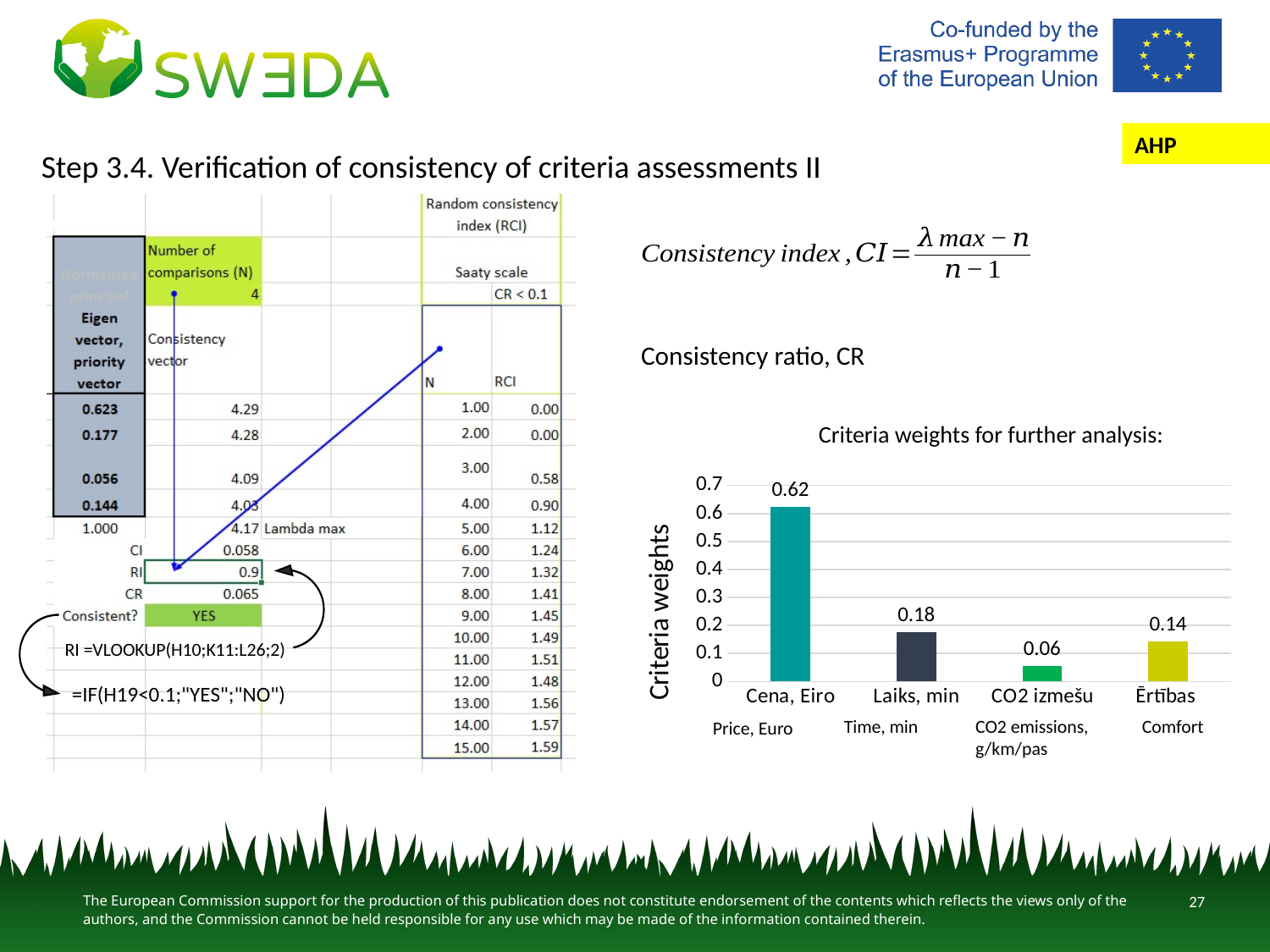
What is the criteria weight for Laiks, min? 0.18 What is the criteria weight for Ērtības? 0.14 Which has a larger weight, Laiks, min or Ērtības? Laiks, min Is the value for Cena, Eiro greater or less than 0.5? greater Which criterion has the lowest weight in the chart? CO2 izmešu Which criterion has the highest weight in the chart? Cena, Eiro What kind of chart is used to show the criteria weights? bar chart What is the criteria weight for CO2 izmešu? 0.06 How many criteria are shown in the bar chart? 4 What is the difference between the weights of Cena, Eiro and Laiks, min? 0.44 What is the criteria weight for Cena, Eiro? 0.62 What is the label of the vertical axis of the chart? Criteria weights